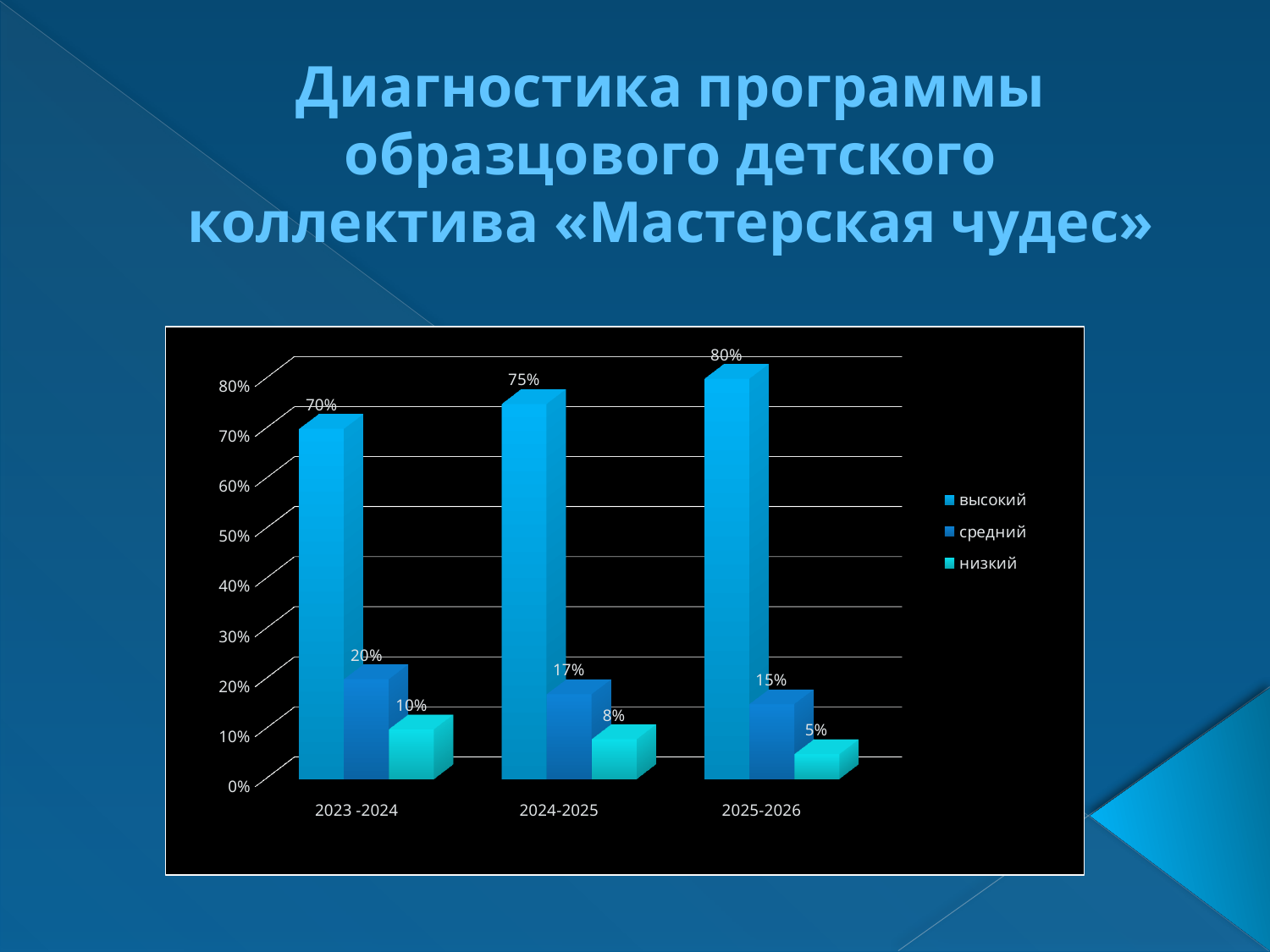
Does the value for низкий rise or fall from 2023 -2024 to 2025-2026? fall What is the value for средний in 2023 -2024? 20% How many periods are shown on the x axis? 3 What is the difference between the высокий values for 2025-2026 and 2023 -2024? 10% What kind of chart is shown on the slide? bar chart What is the value for низкий in 2024-2025? 8% What is the value for высокий in 2025-2026? 80% Which is larger: средний in 2024-2025 or средний in 2025-2026? средний in 2024-2025 In which period is the value for высокий the highest? 2025-2026 In which period is the value for низкий the lowest? 2025-2026 Is the value for высокий in 2024-2025 greater or less than 70%? greater How many series does the legend list? 3